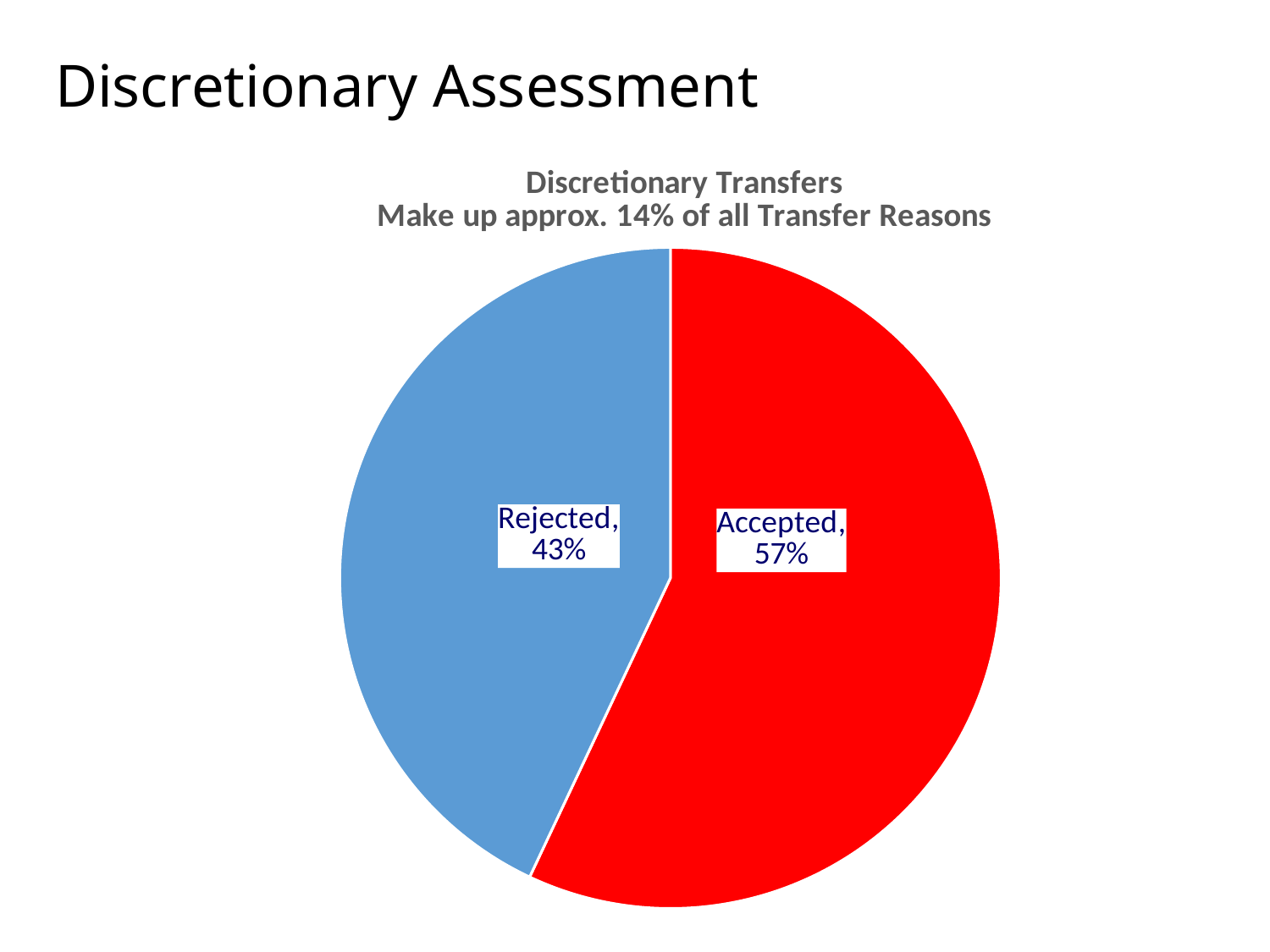
What is the share for Accepted? 57% What is the share for Rejected? 43% Which is larger, Accepted or Rejected? Accepted What is the difference in percentage points between Accepted and Rejected? 14 What is the title of the chart? Discretionary Transfers Make up approx. 14% of all Transfer Reasons What is the combined share of Accepted and Rejected? 100% Which slice is the largest? Accepted Which slice is the smallest? Rejected How many slices does the pie chart have? 2 What colour is the Accepted slice? red What type of chart is shown on the slide? pie chart